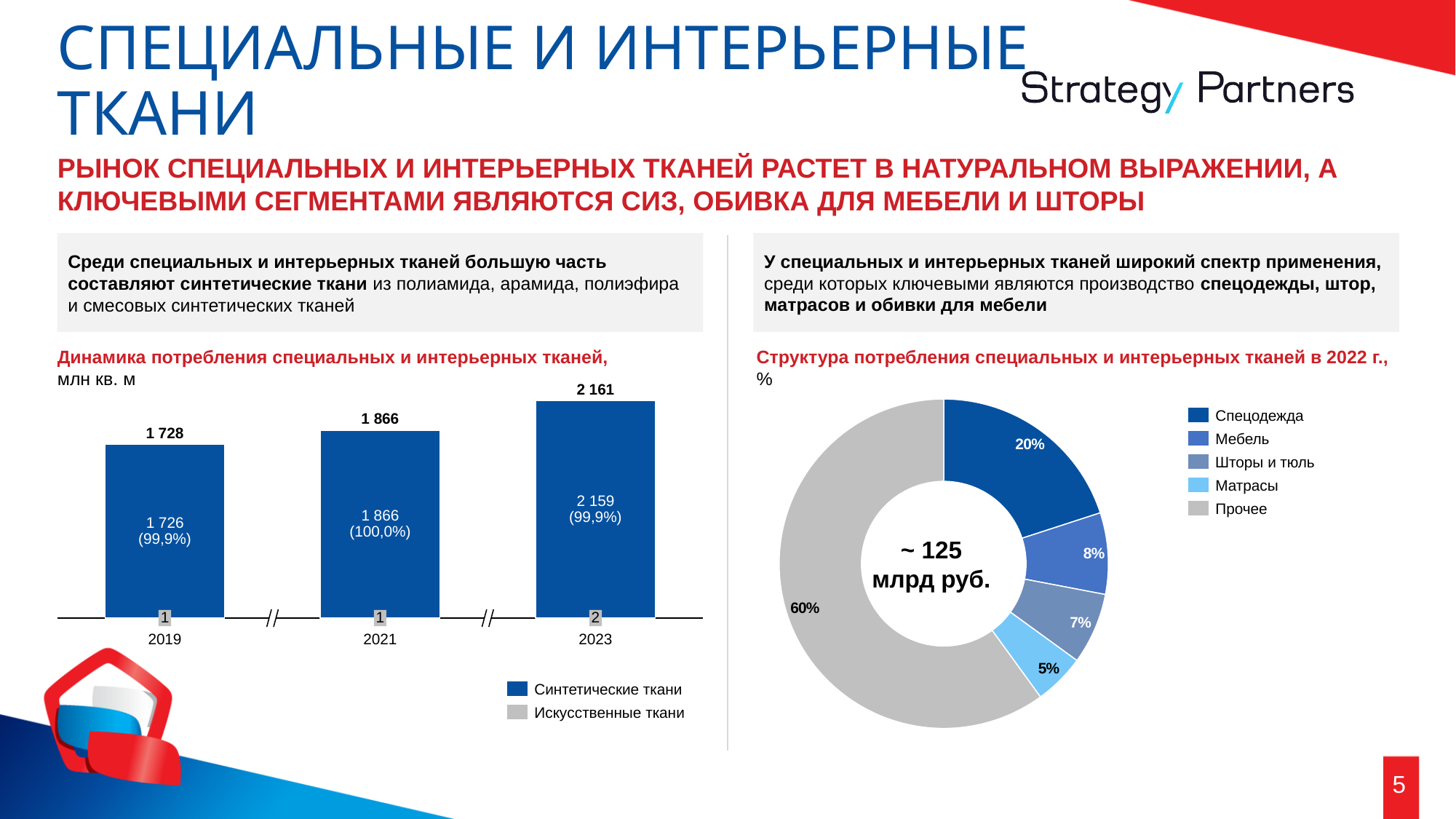
On the right chart 'Структура потребления специальных и интерьерных тканей в 2022 г.', what share does Спецодежда have? 20% On the left chart 'Динамика потребления специальных и интерьерных тканей', what is the total value for 2023? 2 161 On the left chart 'Динамика потребления специальных и интерьерных тканей', what is the value of Синтетические ткани in 2019? 1 726 On the left chart 'Динамика потребления специальных и интерьерных тканей', do the totals rise or fall from 2019 to 2023? rise What kind of chart is the left chart 'Динамика потребления специальных и интерьерных тканей'? stacked bar chart On the left chart 'Динамика потребления специальных и интерьерных тканей', which year has the highest total? 2023 On the right chart 'Структура потребления специальных и интерьерных тканей в 2022 г.', which category has the smallest share? Матрасы On the right chart 'Структура потребления специальных и интерьерных тканей в 2022 г.', which is larger: Мебель or Шторы и тюль? Мебель On the right chart 'Структура потребления специальных и интерьерных тканей в 2022 г.', how many categories does the legend list? 5 On the left chart 'Динамика потребления специальных и интерьерных тканей', how many series does the legend list? 2 On the left chart 'Динамика потребления специальных и интерьерных тканей', what is the difference between the totals for 2023 and 2019? 433 On the left chart 'Динамика потребления специальных и интерьерных тканей', what is the value of Искусственные ткани in 2023? 2